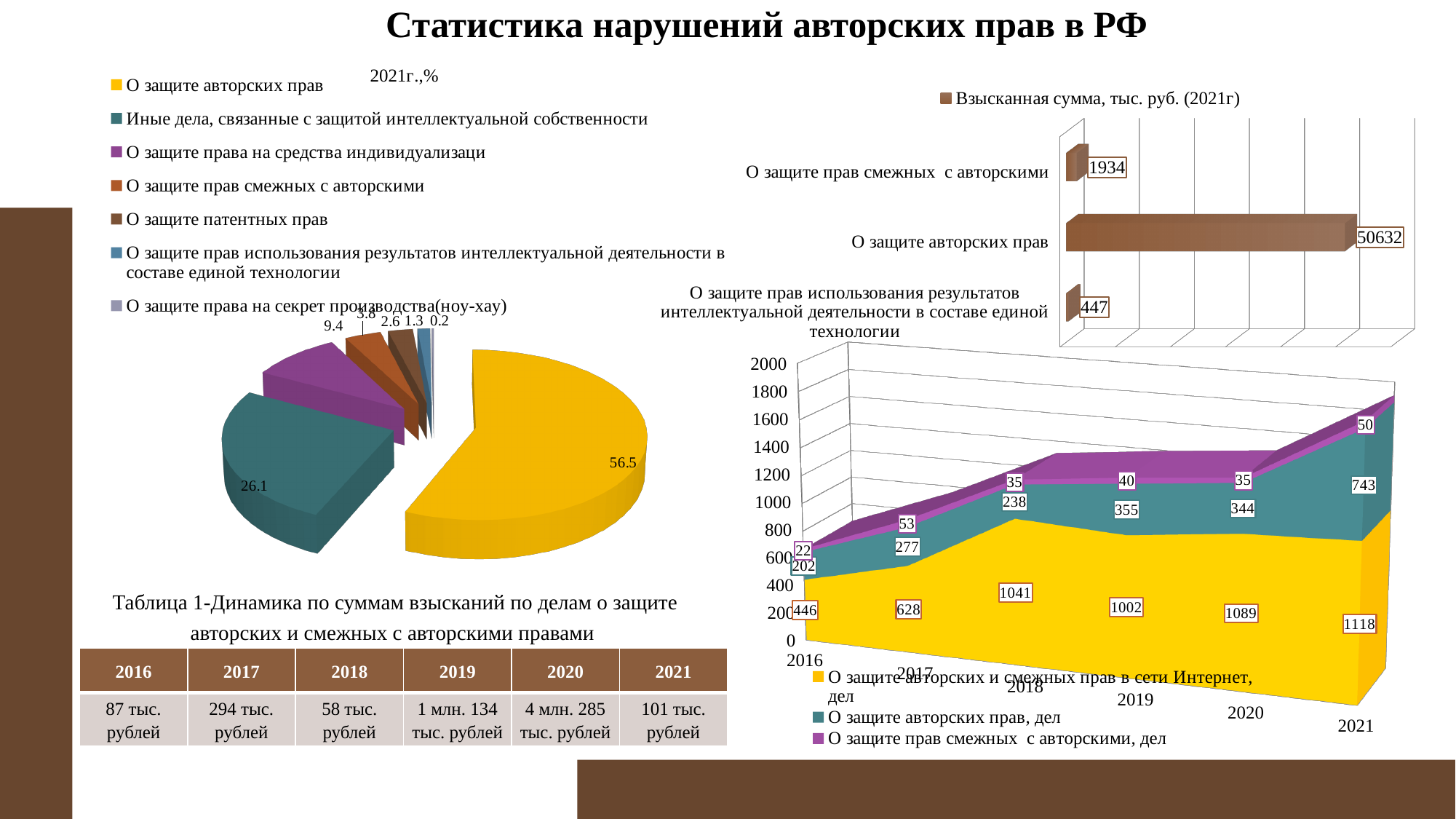
In the pie chart (2021г.,%), what share is shown for 'Иные дела, связанные с защитой интеллектуальной собственности'? 26.1 In the pie chart (2021г.,%), which category has the smallest share? О защите права на секрет производства(ноу-хау) In the area chart at the bottom right, how many series does the legend list? 3 In the area chart at the bottom right, what is the total of the three series in 2016? 670 In the area chart at the bottom right, what is the value for 'О защите авторских и смежных прав в сети Интернет, дел' in 2018? 1041 In the bar chart 'Взысканная сумма, тыс. руб. (2021г)', what is the value for 'О защите прав смежных с авторскими'? 1934 In the bar chart 'Взысканная сумма, тыс. руб. (2021г)', what is the difference between the values for 'О защите прав смежных с авторскими' and 'О защите прав использования результатов интеллектуальной деятельности в составе единой технологии'? 1487 In the bar chart 'Взысканная сумма, тыс. руб. (2021г)', what is the value for 'О защите авторских прав'? 50632 In the pie chart (2021г.,%), how many slices are there? 7 In the area chart at the bottom right, what is the value for 'О защите авторских прав, дел' in 2021? 743 In the pie chart (2021г.,%), what share is shown for 'О защите авторских прав'? 56.5 What type of chart is the chart titled 'Взысканная сумма, тыс. руб. (2021г)'? bar chart